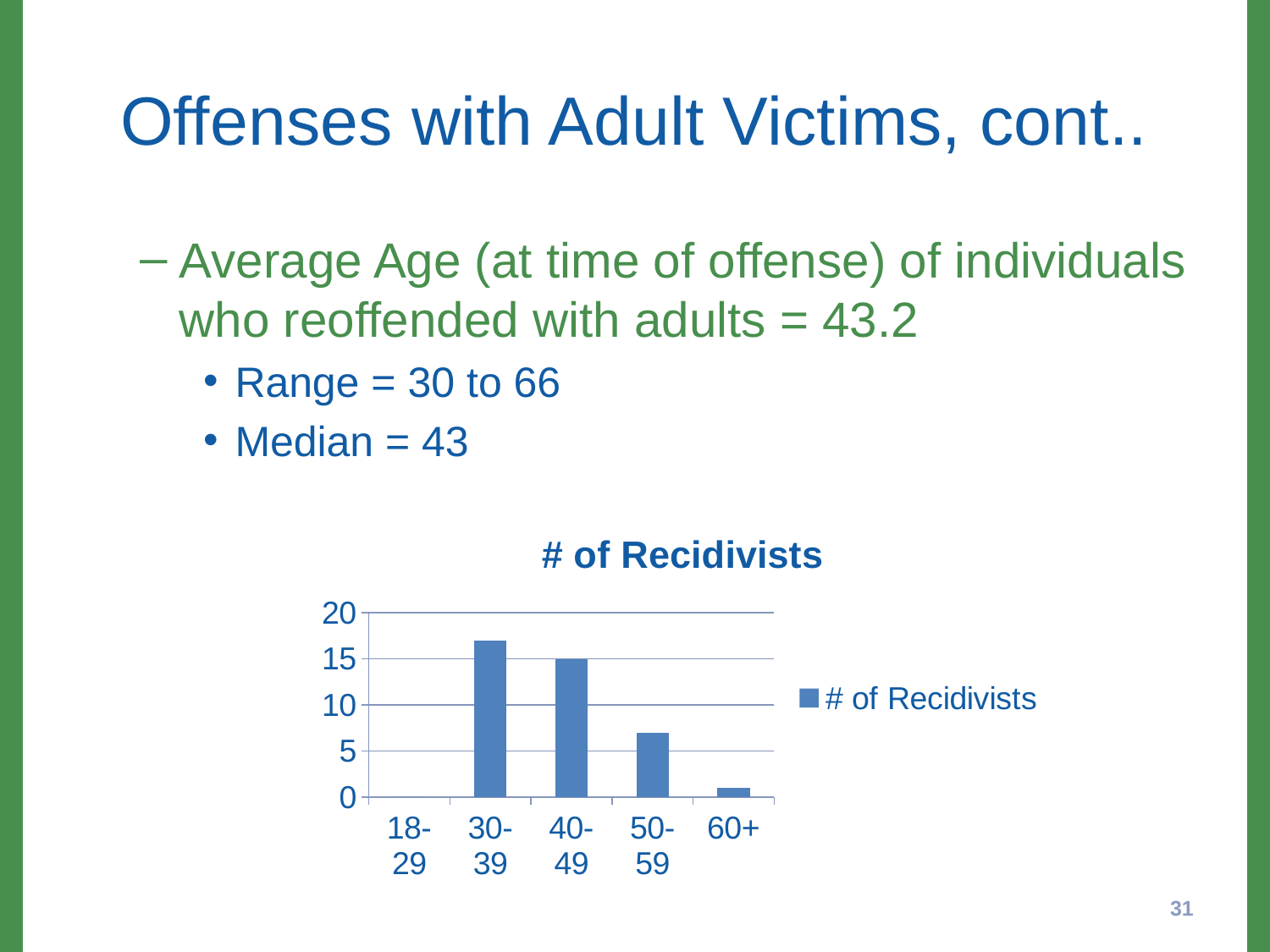
How many series does the chart legend list? 1 How many age categories are shown on the x axis of the chart? 5 What is the title of the chart? # of Recidivists Is the number of recidivists for the 50-59 age group greater or less than 10? less Which age group has the highest number of recidivists? 30-39 What is the number of recidivists for the 40-49 age group? 15 What kind of chart is shown on the slide? bar chart From the 30-39 age group to the 60+ age group, do the values rise or fall? fall Is the number of recidivists for the 30-39 age group greater or less than 15? greater Which has more recidivists, the 40-49 age group or the 50-59 age group? 40-49 Is the number of recidivists for the 60+ age group greater or less than 5? less Which age group has the lowest number of recidivists? 18-29